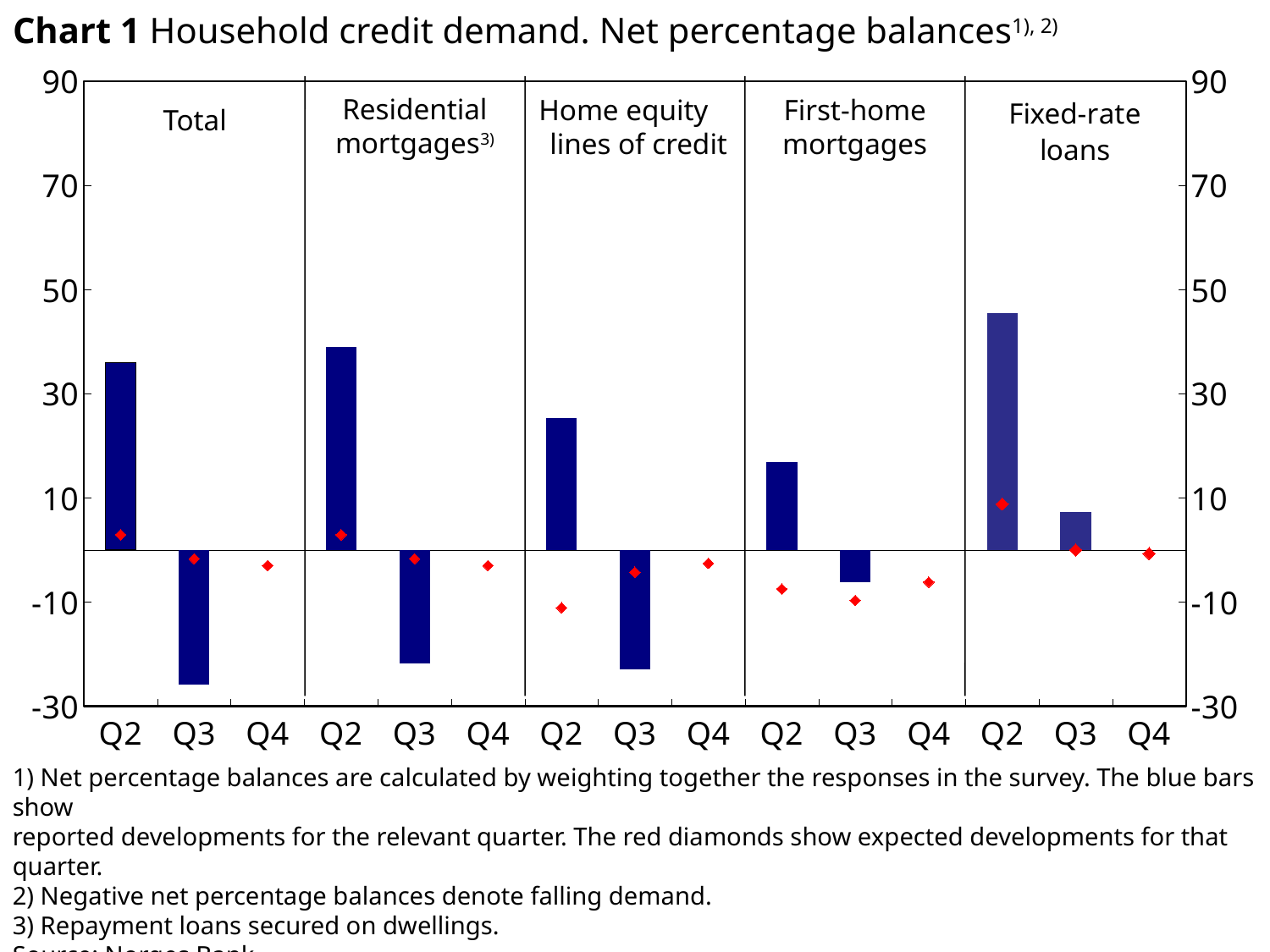
Is the Q2 bar for Total greater or less than 30? greater How many loan categories (panels) does Chart 1 show? 5 Which category has the highest Q2 bar in Chart 1? Fixed-rate loans How many quarters are shown on the x axis of each panel in Chart 1? 3 According to the footnote, what do the red diamonds in Chart 1 show? Expected developments for that quarter Is the Q2 bar for Home equity lines of credit greater or less than 30? less Is the Q2 bar for First-home mortgages greater or less than 30? less Which is larger in Chart 1: the Q2 bar for Residential mortgages or the Q2 bar for Home equity lines of credit? Residential mortgages What kind of chart is Chart 1? Combination bar and line chart (bars with red diamond markers) Do the bars for Fixed-rate loans rise or fall from Q2 to Q3? Fall